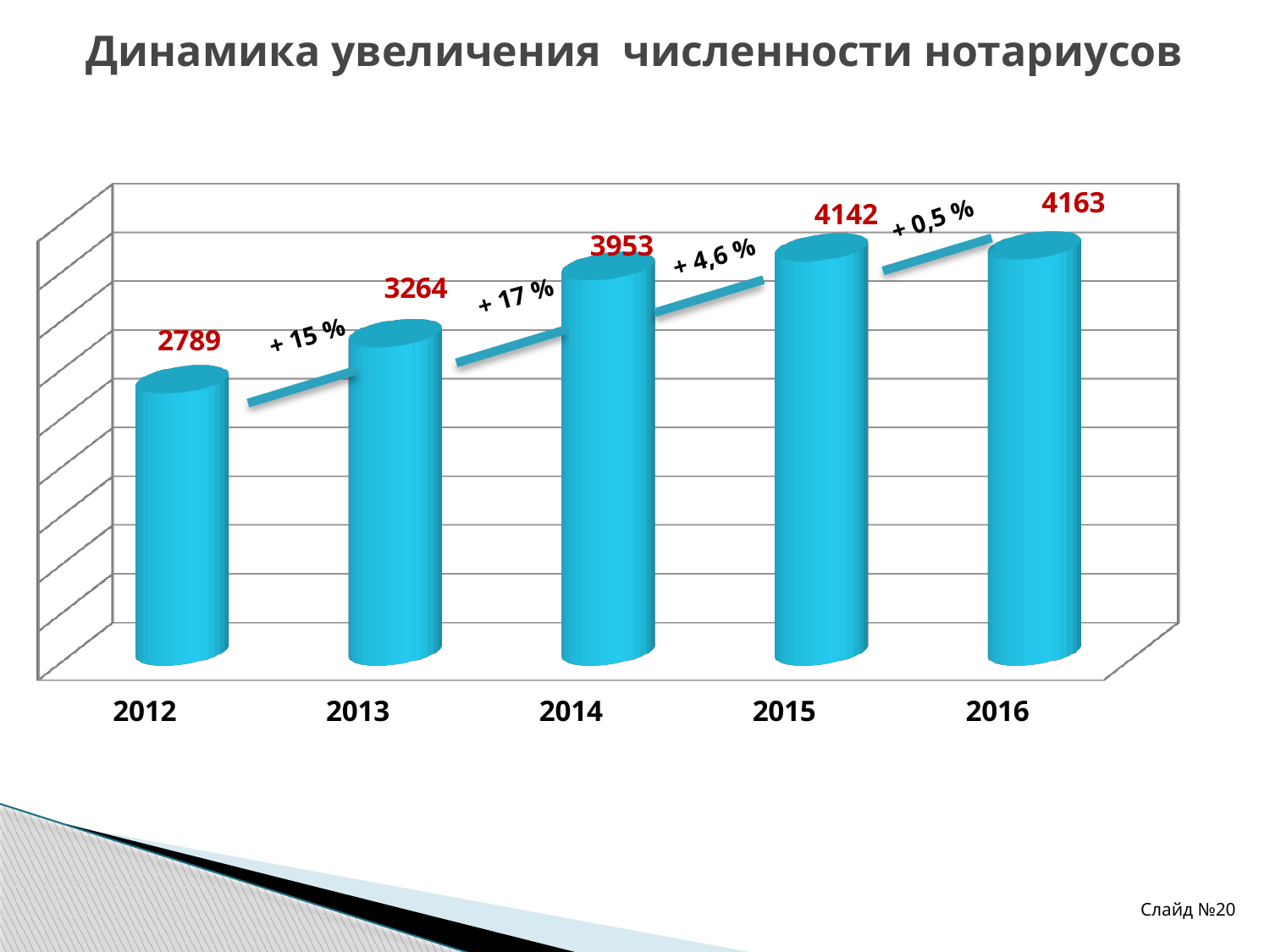
Which is larger, the value for 2013 or the value for 2014? 2014 How many years are shown on the x axis? 5 What is the difference between the values for 2016 and 2015? 21 What is the value for 2012? 2789 What is the value for 2014? 3953 Which year has the lowest value? 2012 Which year has the highest value? 2016 What percentage increase is labelled between 2013 and 2014? + 17 % What is the value for 2016? 4163 What is the difference between the values for 2013 and 2012? 475 What kind of chart is this? bar chart Do the values rise or fall from 2012 to 2016? rise